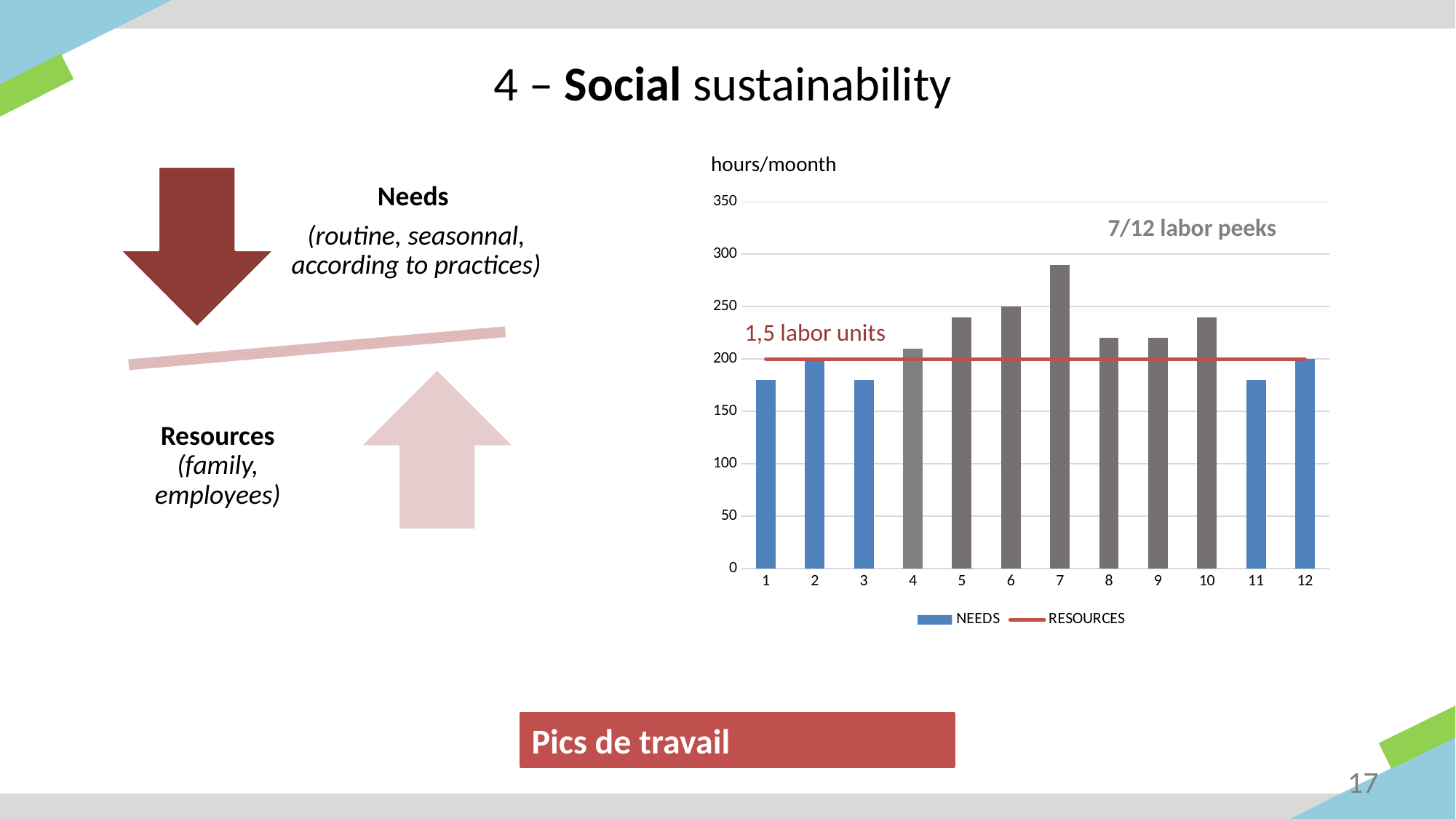
How many categories (months) are shown on the x axis of the chart? 12 How many series does the chart legend list? 2 What are the two series named in the chart legend? NEEDS and RESOURCES Which is larger, the NEEDS value for month 6 or for month 3? month 6 What unit label is shown above the chart's vertical axis? hours/moonth Which is larger, the NEEDS value for month 7 or for month 4? month 7 Is the NEEDS value for month 1 greater or less than 200? less Is the NEEDS value for month 11 greater or less than 200? less Is the NEEDS value for month 7 greater or less than 250? greater Which month has the highest NEEDS value in the chart? 7 What kind of chart is shown on the slide? bar and line chart